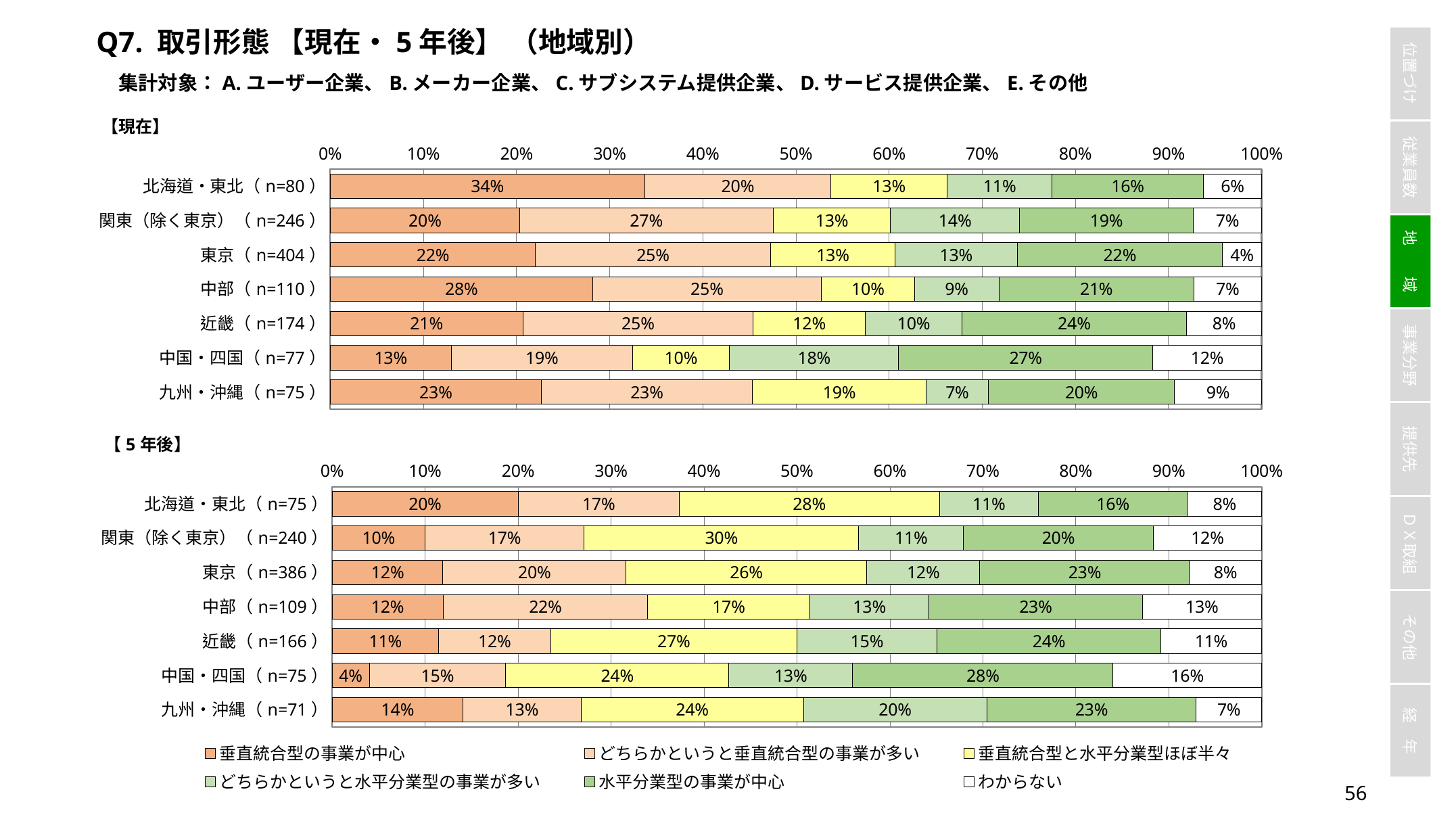
In the 【現在】 chart, what is the difference between the 垂直統合型の事業が中心 values for 中部 (n=110) and 近畿 (n=174)? 7% In the 【現在】 chart, what is the value for わからない for 東京 (n=404)? 4% What kind of chart is the 【現在】 chart? Stacked bar chart In the 【5年後】 chart, what is the value for どちらかというと水平分業型の事業が多い for 九州・沖縄 (n=71)? 20% In the 【5年後】 chart, what is the value for 垂直統合型と水平分業型ほぼ半々 for 関東（除く東京）(n=240)? 30% In the 【5年後】 chart, which is larger for 東京 (n=386): 垂直統合型と水平分業型ほぼ半々 or 水平分業型の事業が中心? 垂直統合型と水平分業型ほぼ半々 In the 【5年後】 chart, which region has the lowest value for 垂直統合型の事業が中心? 中国・四国 (n=75) In the 【現在】 chart, which region has the highest value for 垂直統合型の事業が中心? 北海道・東北 (n=80) In the 【現在】 chart, what is the difference between the 水平分業型の事業が中心 values for 中国・四国 (n=77) and 九州・沖縄 (n=75)? 7% In the 【現在】 chart, what is the value for 垂直統合型の事業が中心 for 北海道・東北 (n=80)? 34% How many series does the legend list? 6 How many regions are shown in the 【5年後】 chart? 7